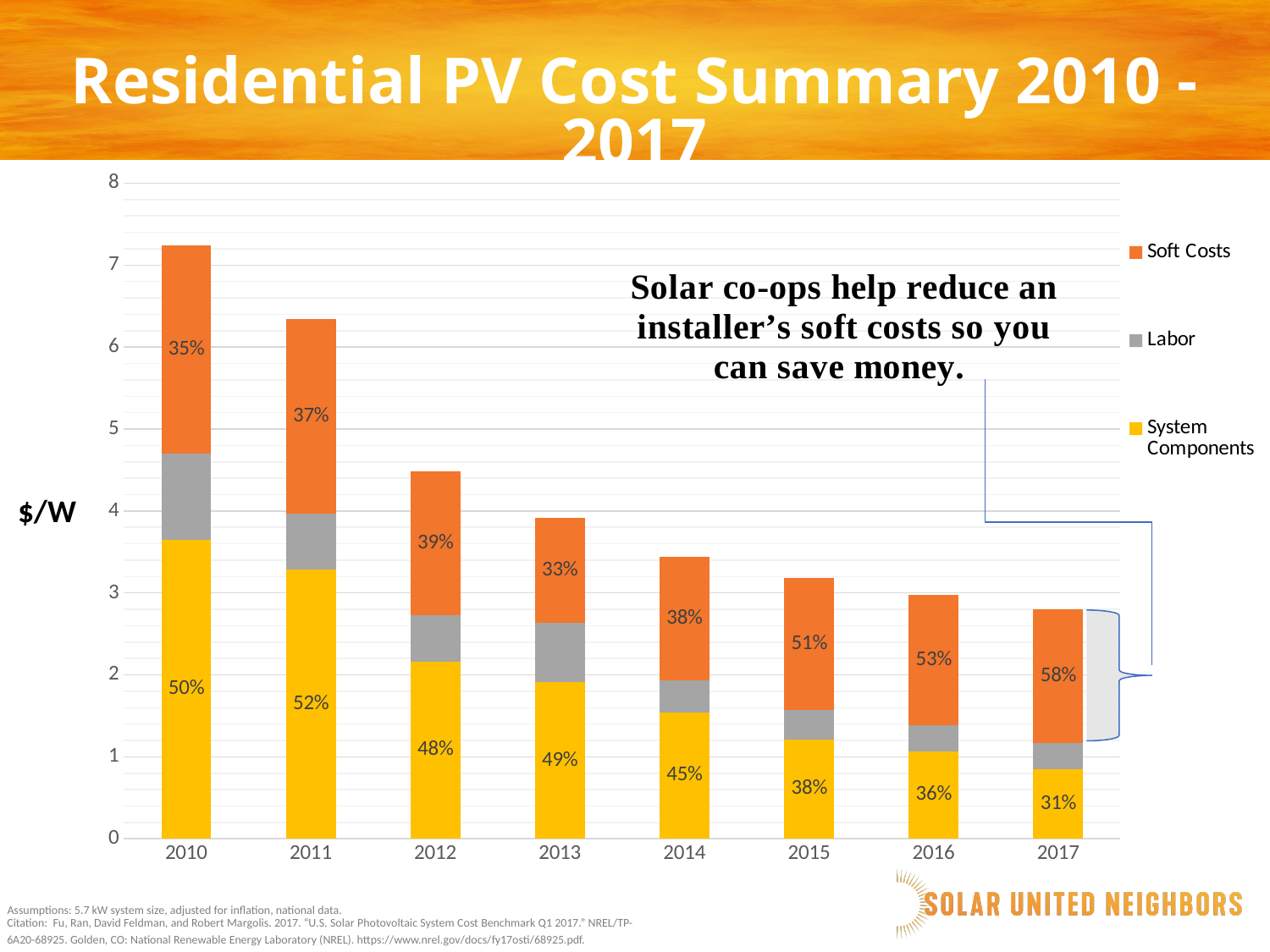
How many years are shown on the x axis? 8 Is the total bar for 2010 greater or less than 7? greater What percentage label is shown for Soft Costs in 2010? 35% Which year has the highest total bar? 2010 What kind of chart is shown on the slide? stacked bar chart What percentage label is shown for Soft Costs in 2017? 58% Which year has the larger Soft Costs percentage label, 2015 or 2016? 2016 What percentage label is shown for System Components in 2017? 31% How many series does the legend list? 3 What percentage label is shown for System Components in 2010? 50% Which year has the lowest total bar? 2017 Do the total bar heights rise or fall from 2010 to 2017? fall